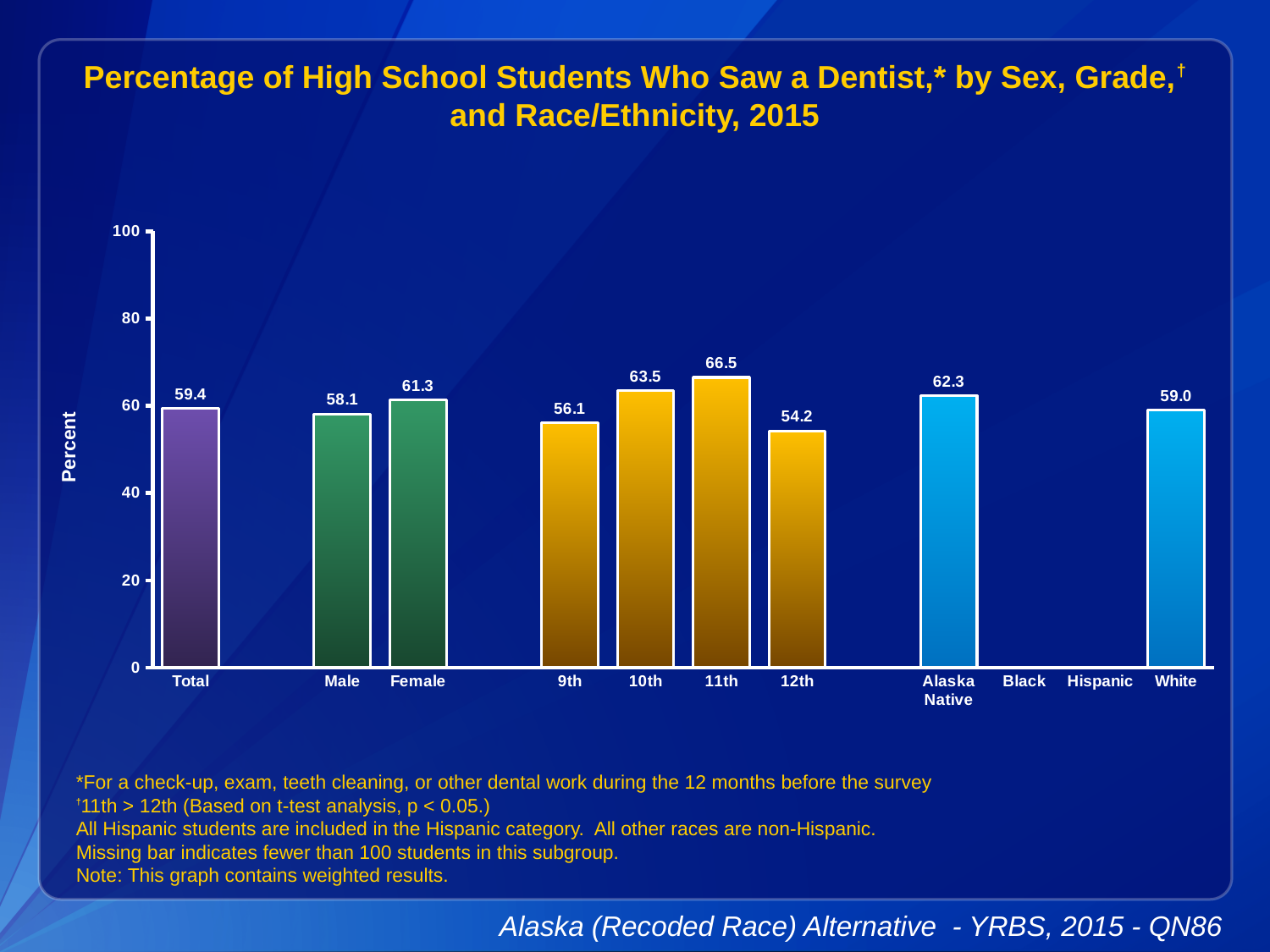
What is the difference between the 11th and 12th grade values? 12.3 What kind of chart is shown? bar chart What is the value for Total? 59.4 What is the value for Alaska Native? 62.3 Which category has the highest value? 11th What is the difference between the Female and Male values? 3.2 How many categories have a plotted bar? 9 Which category with a plotted bar has the lowest value? 12th What is the value for 12th grade? 54.2 Which categories on the x axis have no bar shown? Black and Hispanic What is the value for Female? 61.3 Which is larger, the value for 10th grade or the value for 9th grade? 10th